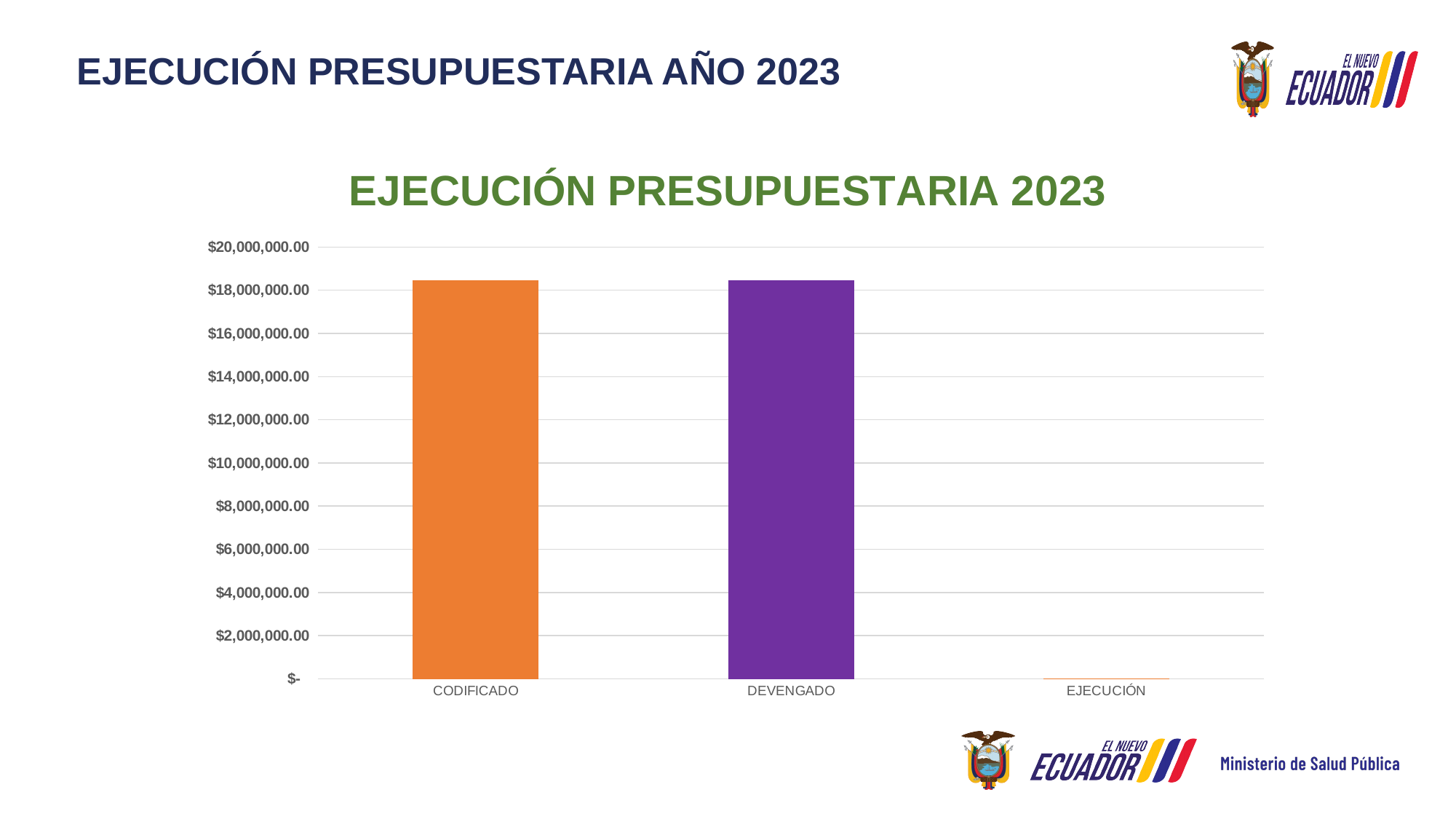
What is the highest value shown on the y axis of the chart? $20,000,000.00 Is the value for CODIFICADO greater or less than $16,000,000.00? greater Is the value for EJECUCIÓN greater or less than $2,000,000.00? less Which category has the lowest value in the chart? EJECUCIÓN How many categories are shown on the x axis of the chart? 3 What kind of chart is shown on the slide? bar chart Which is larger, the value for CODIFICADO or the value for EJECUCIÓN? CODIFICADO Which is larger, the value for DEVENGADO or the value for EJECUCIÓN? DEVENGADO Is the value for DEVENGADO greater or less than $20,000,000.00? less What is the title of the chart? EJECUCIÓN PRESUPUESTARIA 2023